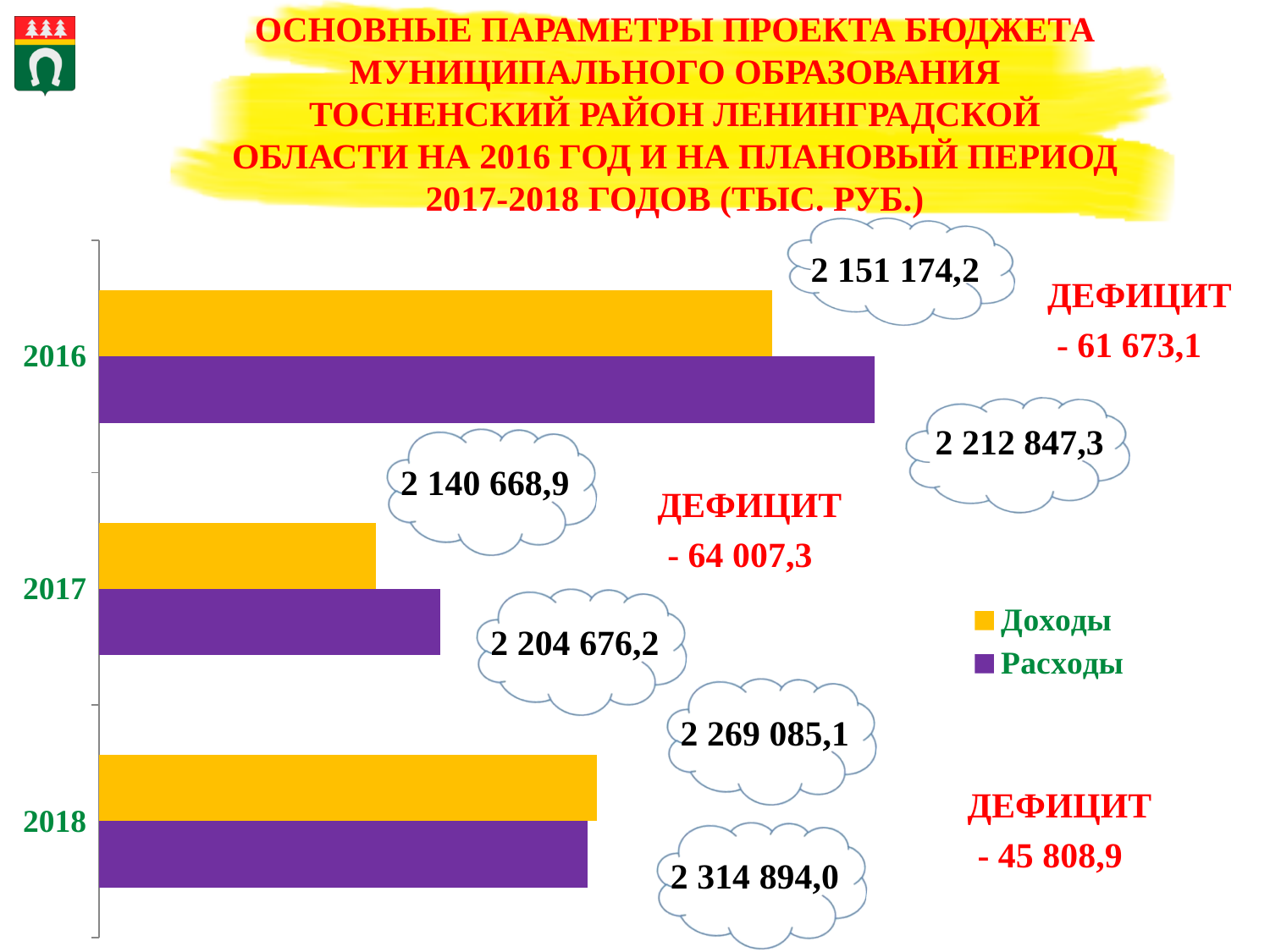
What is the value of Расходы for 2018? 2 314 894,0 What is the difference between Расходы and Доходы in 2018? 45 808,9 What is the value of Доходы for 2018? 2 269 085,1 What is the value of Доходы for 2016? 2 151 174,2 What kind of chart is shown on the slide? Bar chart In 2017, which is larger: Доходы or Расходы? Расходы What is the value of Расходы for 2017? 2 204 676,2 How many years are shown on the chart? 3 How many series does the legend list? 2 What is the value of Доходы for 2017? 2 140 668,9 What is the difference between Расходы and Доходы in 2016? 61 673,1 What is the value of Расходы for 2016? 2 212 847,3